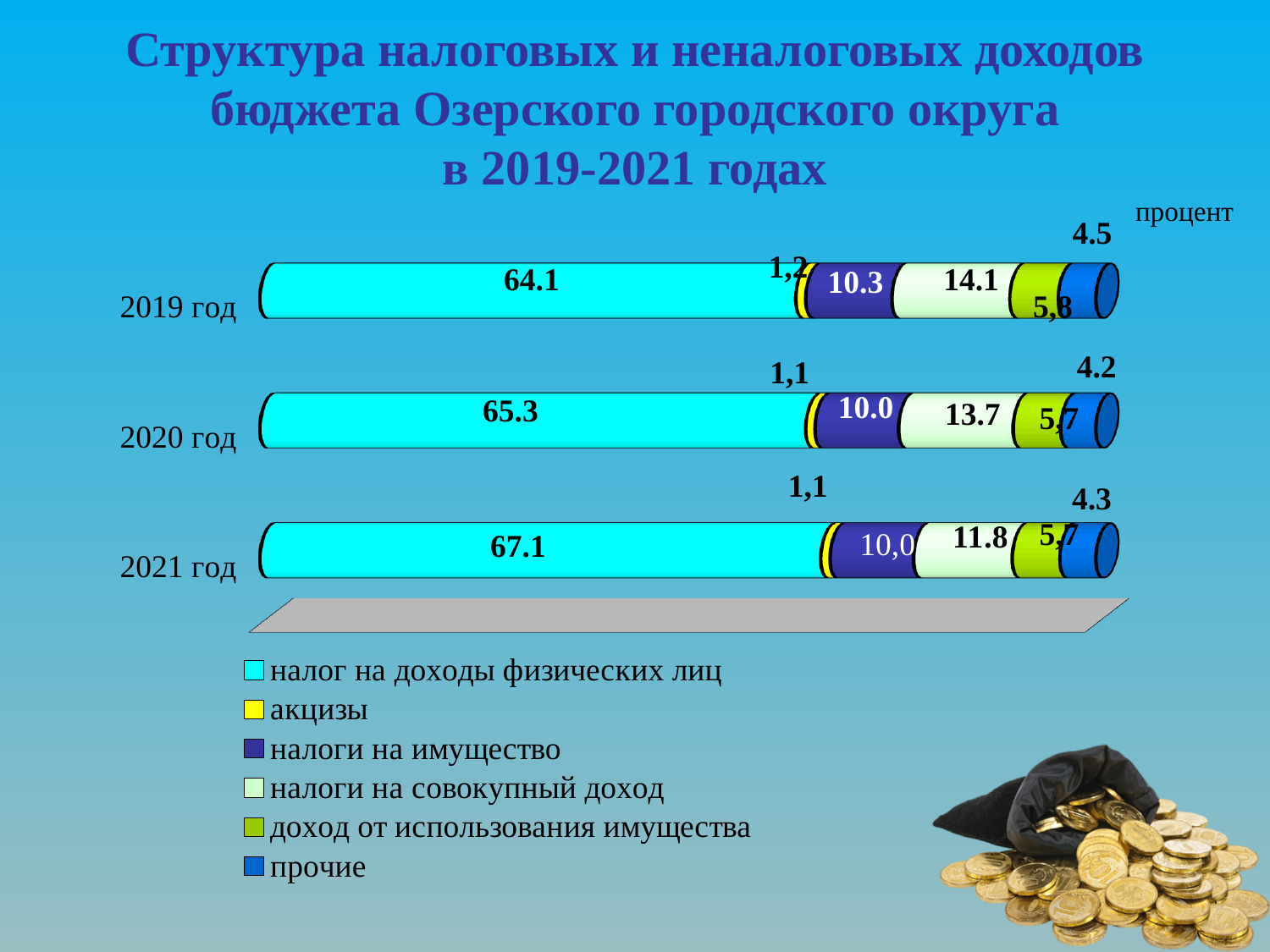
What is the value for прочие in 2020 год? 4.2 In which year is the share of налог на доходы физических лиц the highest? 2021 год How many series does the legend list? 6 How many years (bars) are shown in the chart? 3 What is the value for налоги на имущество in 2019 год? 10.3 What is the value for налоги на совокупный доход in 2019 год? 14.1 By how much did the share of налог на доходы физических лиц in 2021 год exceed that in 2019 год? 3.0 In which year is the share of налоги на совокупный доход the lowest? 2021 год Does the share of налог на доходы физических лиц rise or fall from 2019 to 2021? rises Which year has the larger value for налоги на совокупный доход, 2019 год or 2020 год? 2019 год What is the value for налог на доходы физических лиц in 2021 год? 67.1 What kind of chart is shown on the slide? stacked bar chart